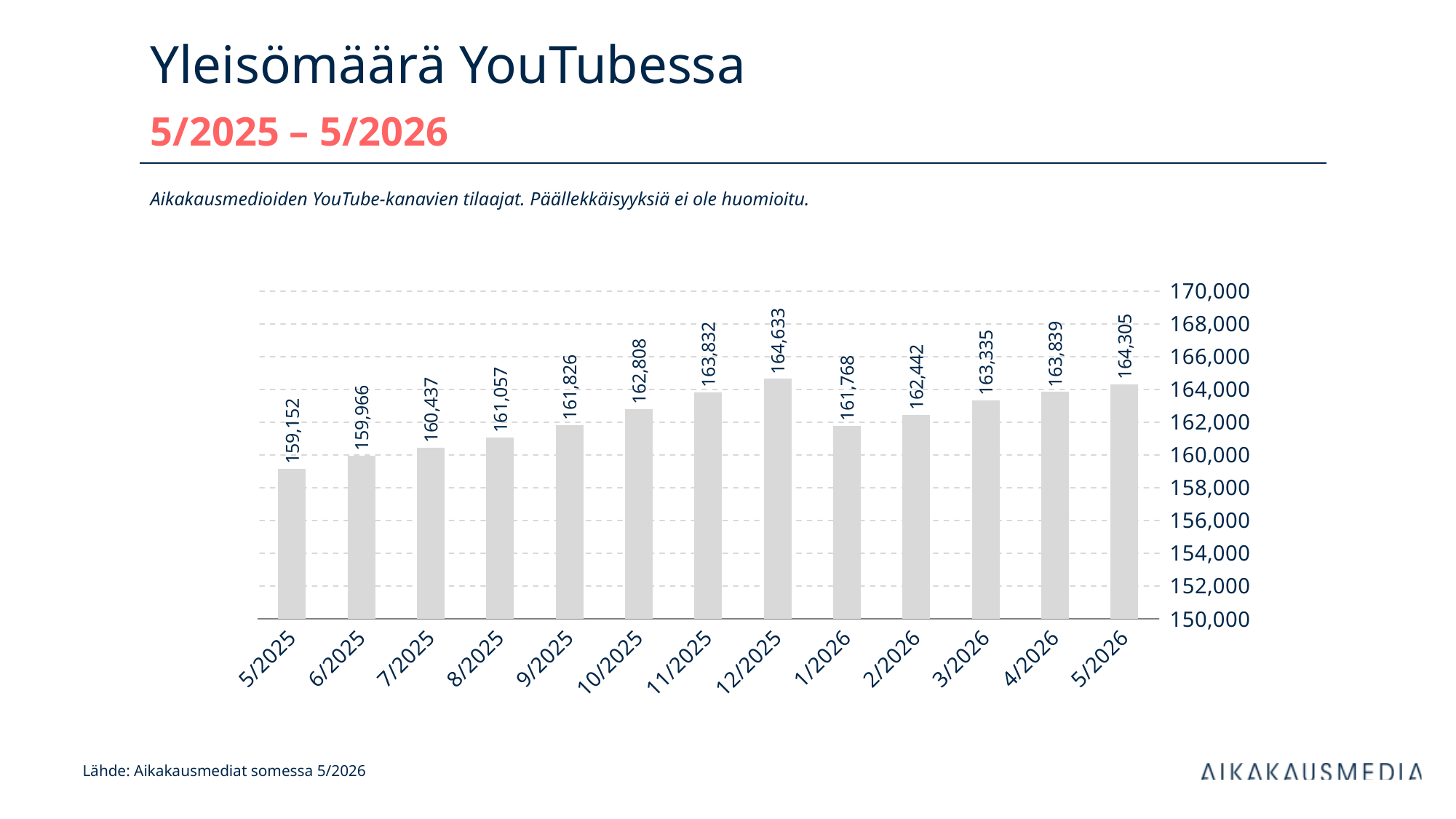
Which month has the highest value? 12/2025 What is the difference between the values for 12/2025 and 1/2026? 2,865 What is the value for 3/2026? 163,335 Is the value for 8/2025 greater or less than 160,000? greater What is the difference between the values for 5/2026 and 5/2025? 5,153 What kind of chart is shown on the slide? bar chart How many months are shown on the x axis? 13 What is the value for 1/2026? 161,768 What is the value for 12/2025? 164,633 What is the value for 5/2025? 159,152 Which is larger, the value for 10/2025 or the value for 2/2026? 10/2025 Which month has the lowest value? 5/2025